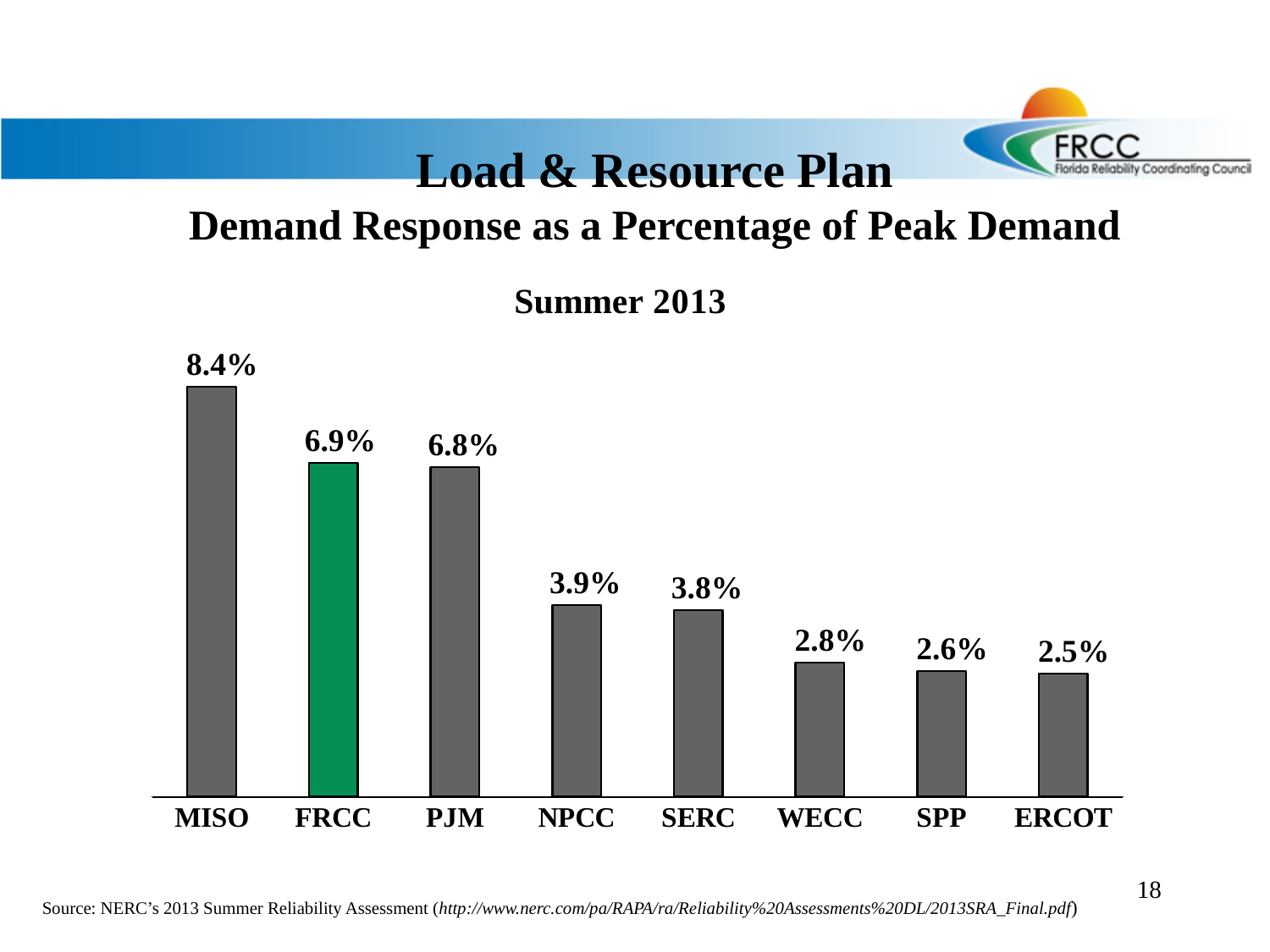
What is the demand response percentage for MISO? 8.4% Which has a larger value, PJM or SERC? PJM What is the value shown for WECC? 2.8% What is the difference between the values for MISO and FRCC? 1.5% What kind of chart is shown on the slide? Bar chart Which region has the lowest value on the chart? ERCOT Which region has the highest demand response as a percentage of peak demand? MISO What is the difference between the values for NPCC and SPP? 1.3% Which bar is coloured green rather than grey? FRCC Do the values rise or fall moving from left to right along the x axis? Fall How many regions are shown on the chart? 8 What is the value shown for FRCC? 6.9%